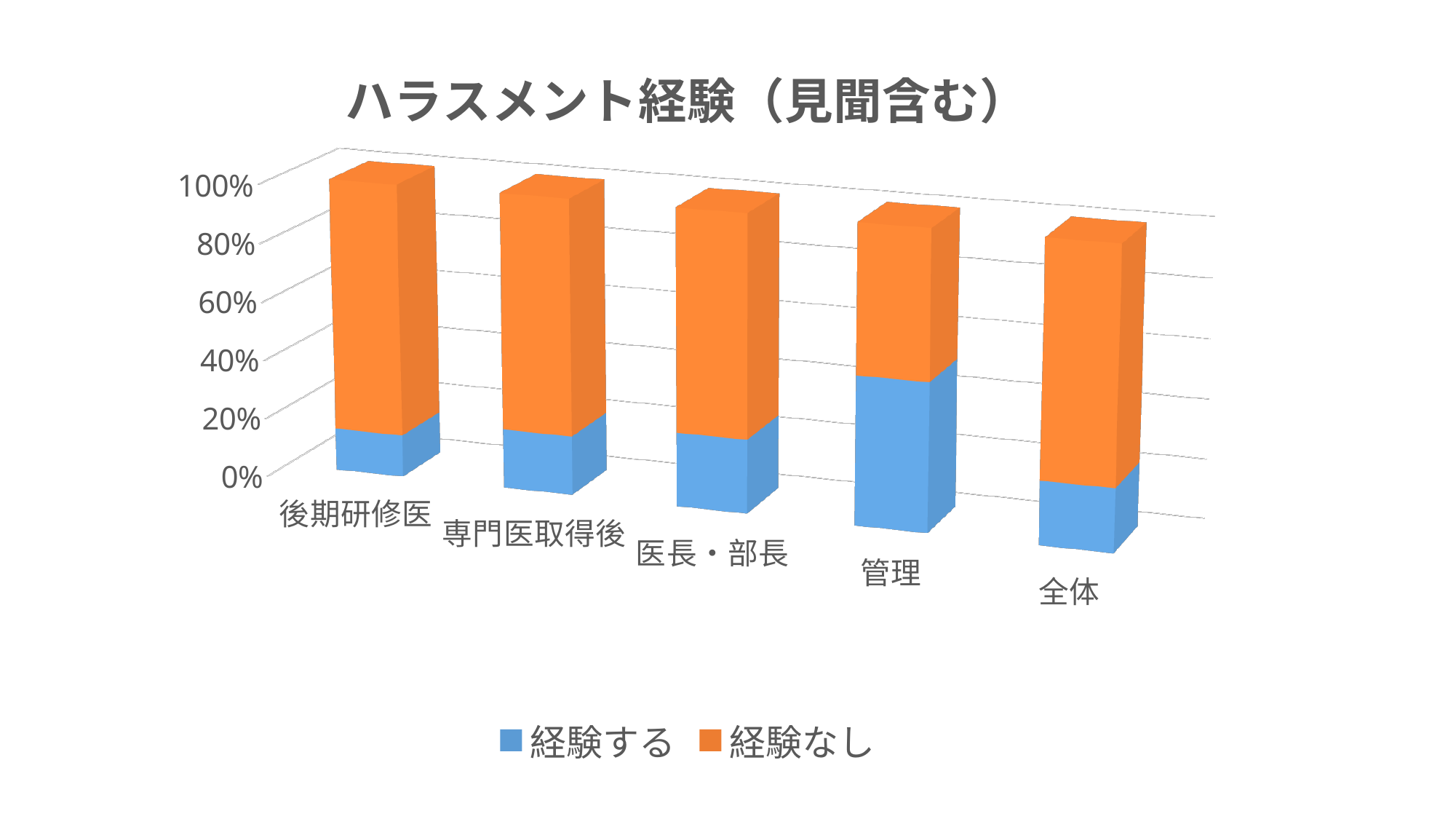
What kind of chart is shown on the slide? Stacked bar chart Which category has the largest 経験する share? 管理 How many categories are shown along the x axis? 5 Is the 経験なし share for 医長・部長 greater or less than 60%? greater Which category has the smallest 経験なし share? 管理 What is the title of the chart? ハラスメント経験（見聞含む） How many series does the legend list? 2 Is the 経験する share for 後期研修医 greater or less than 40%? less Is the 経験する share for 全体 greater or less than 40%? less Which has the larger 経験する share, 管理 or 全体? 管理 Which series is shown in blue? 経験する